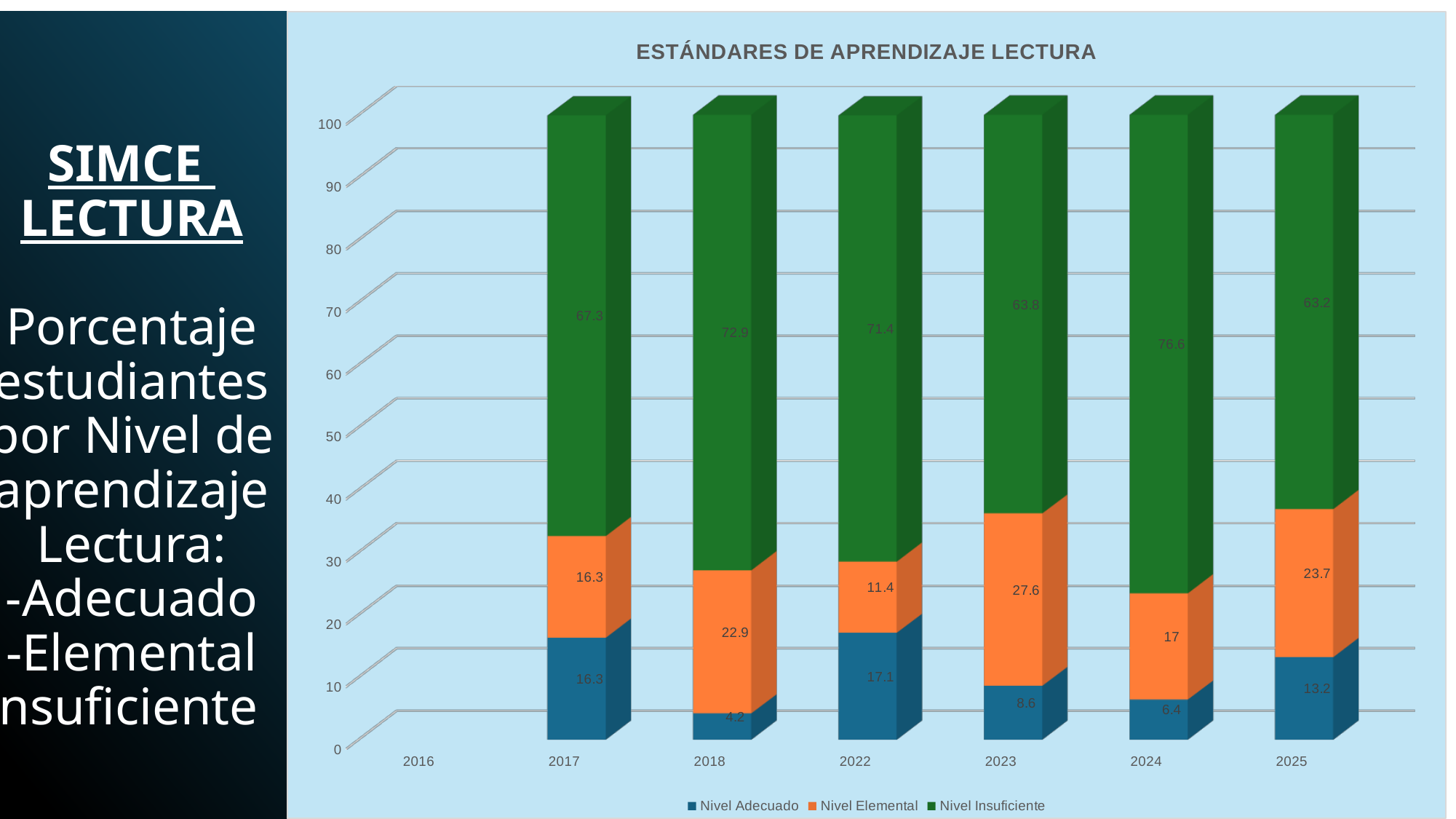
What is the total of the stacked bar for 2017? 99.9 What is the title of the chart? ESTÁNDARES DE APRENDIZAJE LECTURA In which year is the Nivel Insuficiente value highest? 2024 What is the value for Nivel Adecuado in 2022? 17.1 What is the value for Nivel Insuficiente in 2024? 76.6 How many series does the legend list? 3 In which year is the Nivel Adecuado value lowest? 2018 What is the difference between the Nivel Insuficiente values for 2024 and 2025? 13.4 In which year is the Nivel Elemental value highest? 2023 What is the value for Nivel Elemental in 2025? 23.7 Which year has the larger Nivel Elemental value, 2018 or 2022? 2018 What kind of chart is shown on the slide? Stacked bar chart